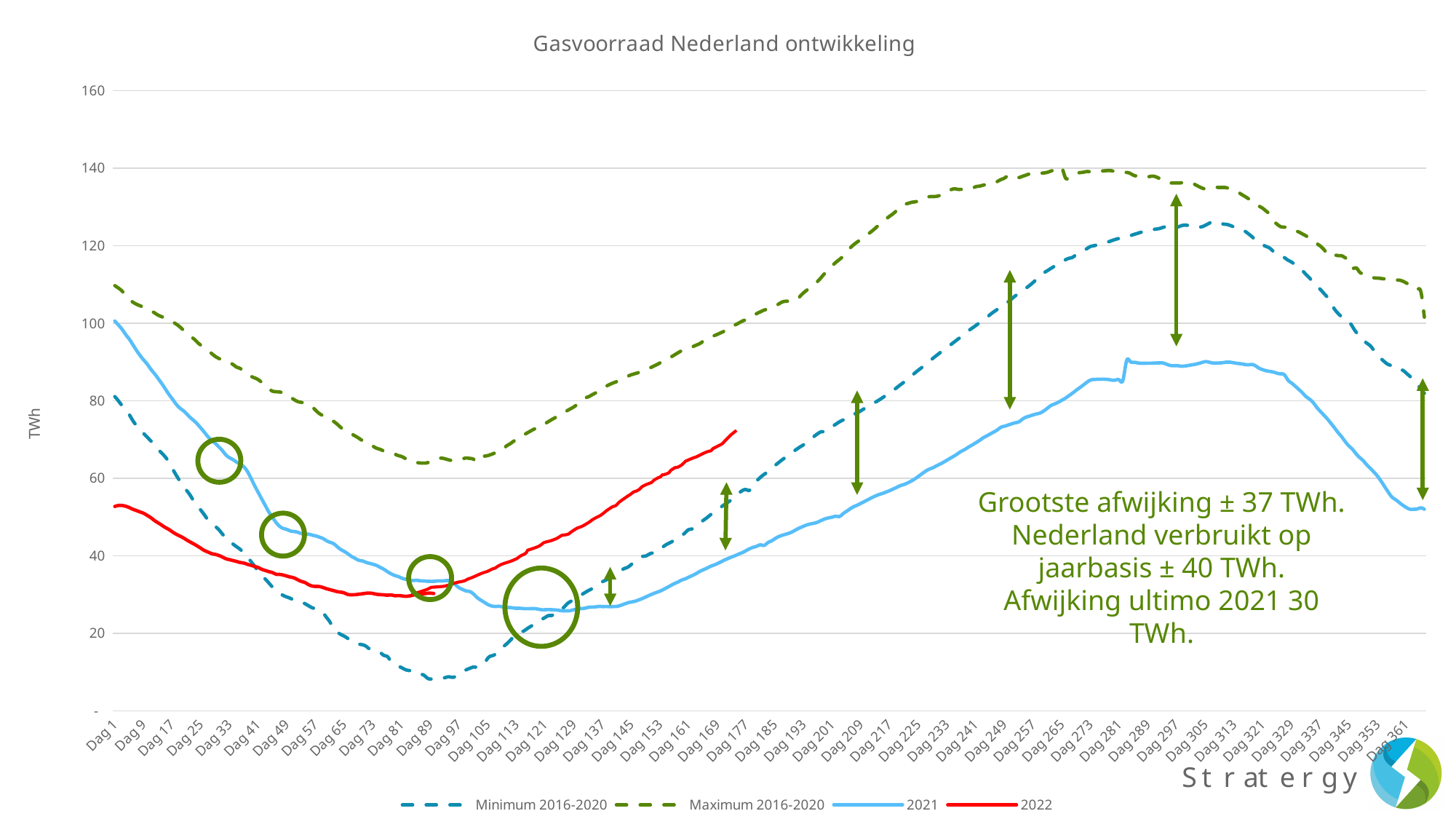
What unit is shown on the vertical axis? TWh At Dag 1, which series is higher, 2021 or 2022? 2021 At Dag 177, which series is higher, 2021 or 2022? 2022 Is the value for 2022 at Dag 1 greater or less than 60? less How many series does the legend list? 4 Is the value for Minimum 2016-2020 at Dag 89 greater or less than 20? less Does the 2022 line rise or fall between Dag 89 and Dag 177? rise Is the value for Maximum 2016-2020 at Dag 1 greater or less than 100? greater What kind of chart is shown on the slide? line chart What is the title of the chart? Gasvoorraad Nederland ontwikkeling